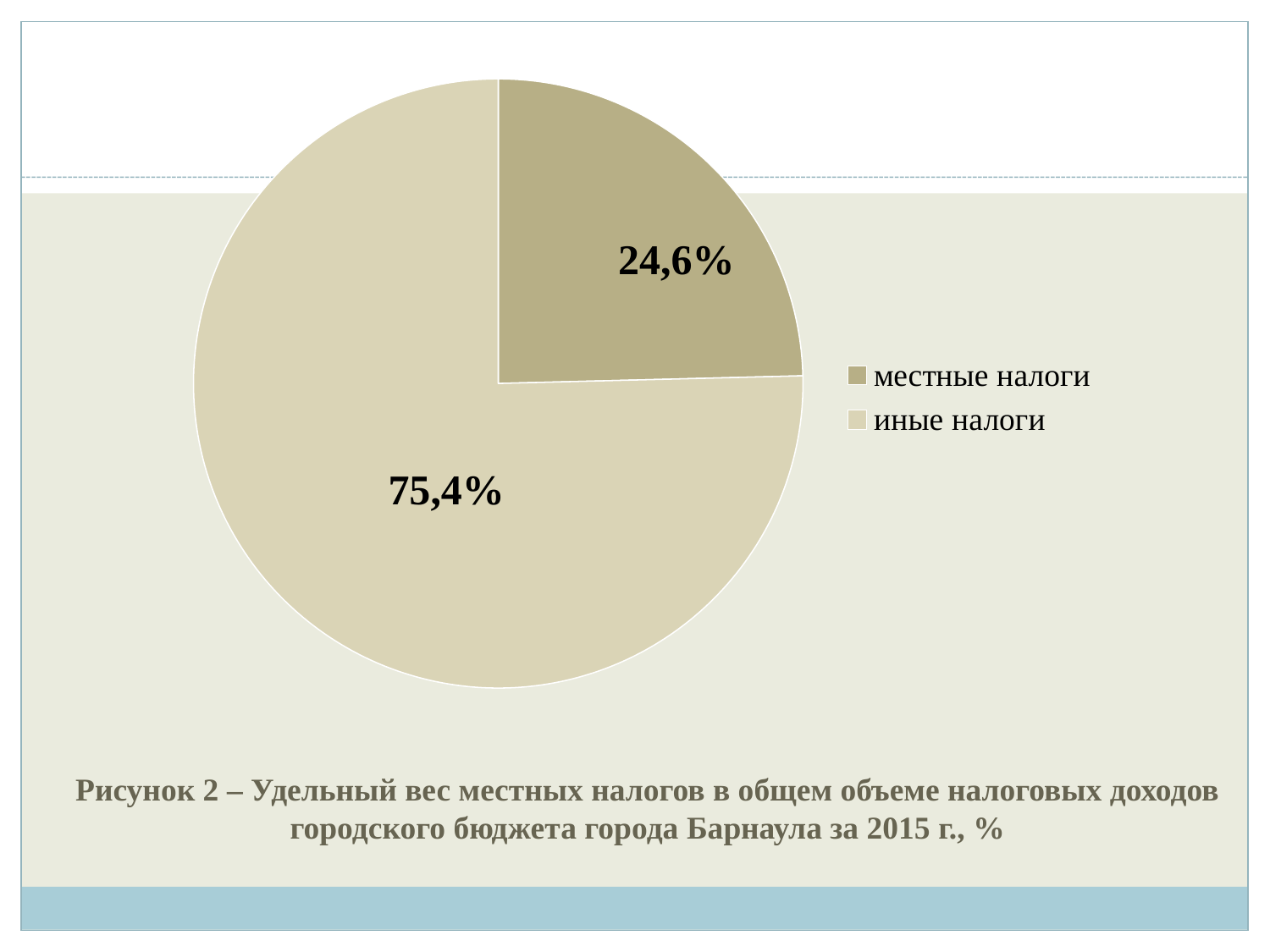
Is the share of "местные налоги" greater or less than 25%? less Which category has the smallest slice of the pie? местные налоги Which category has the largest slice of the pie? иные налоги How many slices does the pie chart have? 2 What share of the pie does "местные налоги" represent? 24,6% Which slice is larger: "местные налоги" or "иные налоги"? иные налоги How many entries does the legend list? 2 What kind of chart is shown on the slide? pie chart What share of the pie does "иные налоги" represent? 75,4% What year does the chart caption refer to? 2015 What is the difference in percentage points between the "иные налоги" and "местные налоги" slices? 50,8 Which city does the chart caption refer to? Барнаул